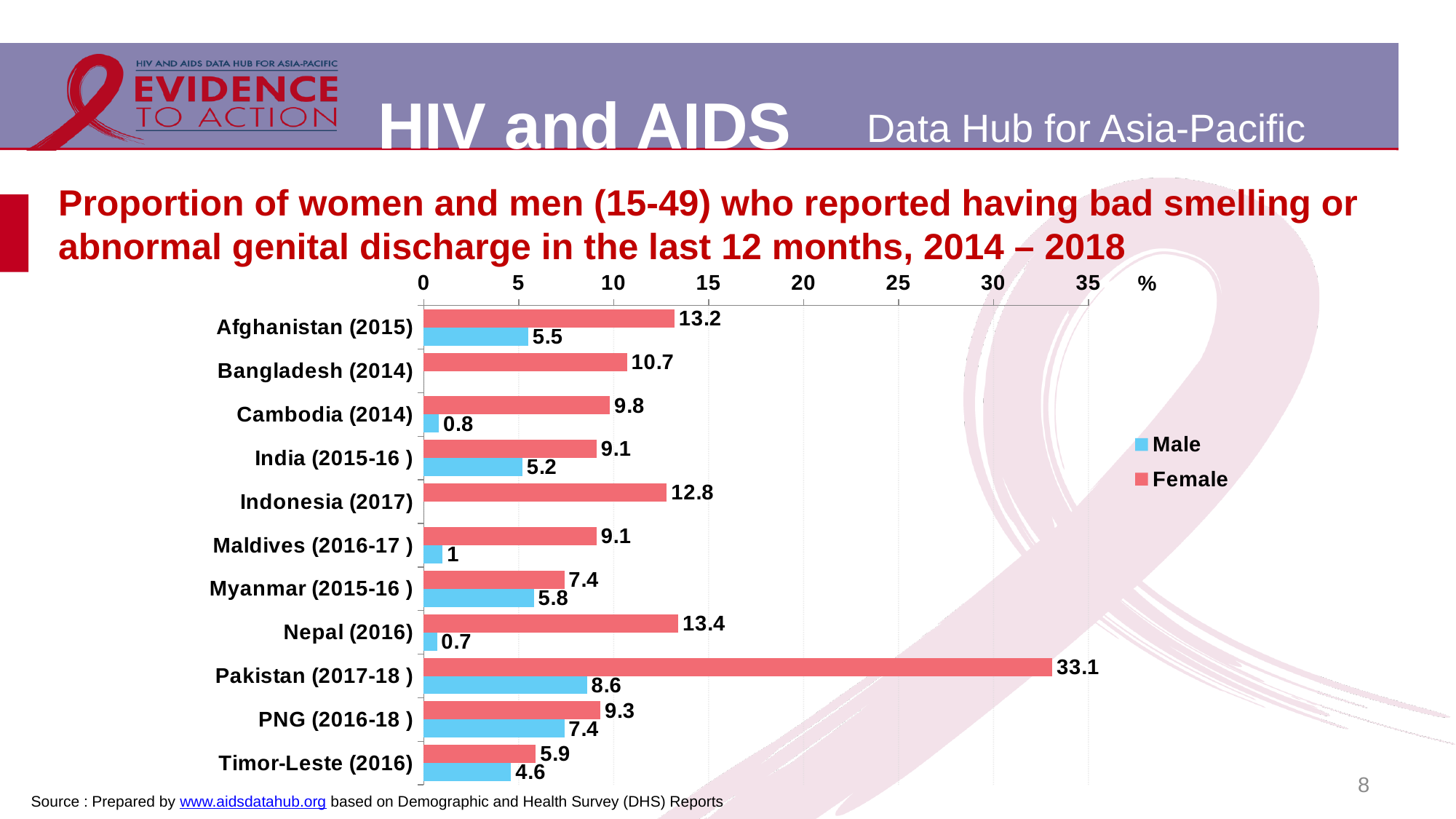
What is the Female value for Pakistan (2017-18)? 33.1 Which country has the lowest Male value among those with a Male bar? Nepal (2016) What is the Male value for Timor-Leste (2016)? 4.6 Which country has the highest Female value? Pakistan (2017-18) What kind of chart is shown on the slide? Bar chart What is the Male value for Afghanistan (2015)? 5.5 Is the Female value for Pakistan (2017-18) greater or less than 30? greater What is the Female value for Nepal (2016)? 13.4 Which is larger, the Male value for Myanmar (2015-16) or the Male value for India (2015-16)? Myanmar (2015-16) What is the difference between the Female and Male values for Pakistan (2017-18)? 24.5 How many countries are shown on the chart? 11 How many series does the legend list? 2